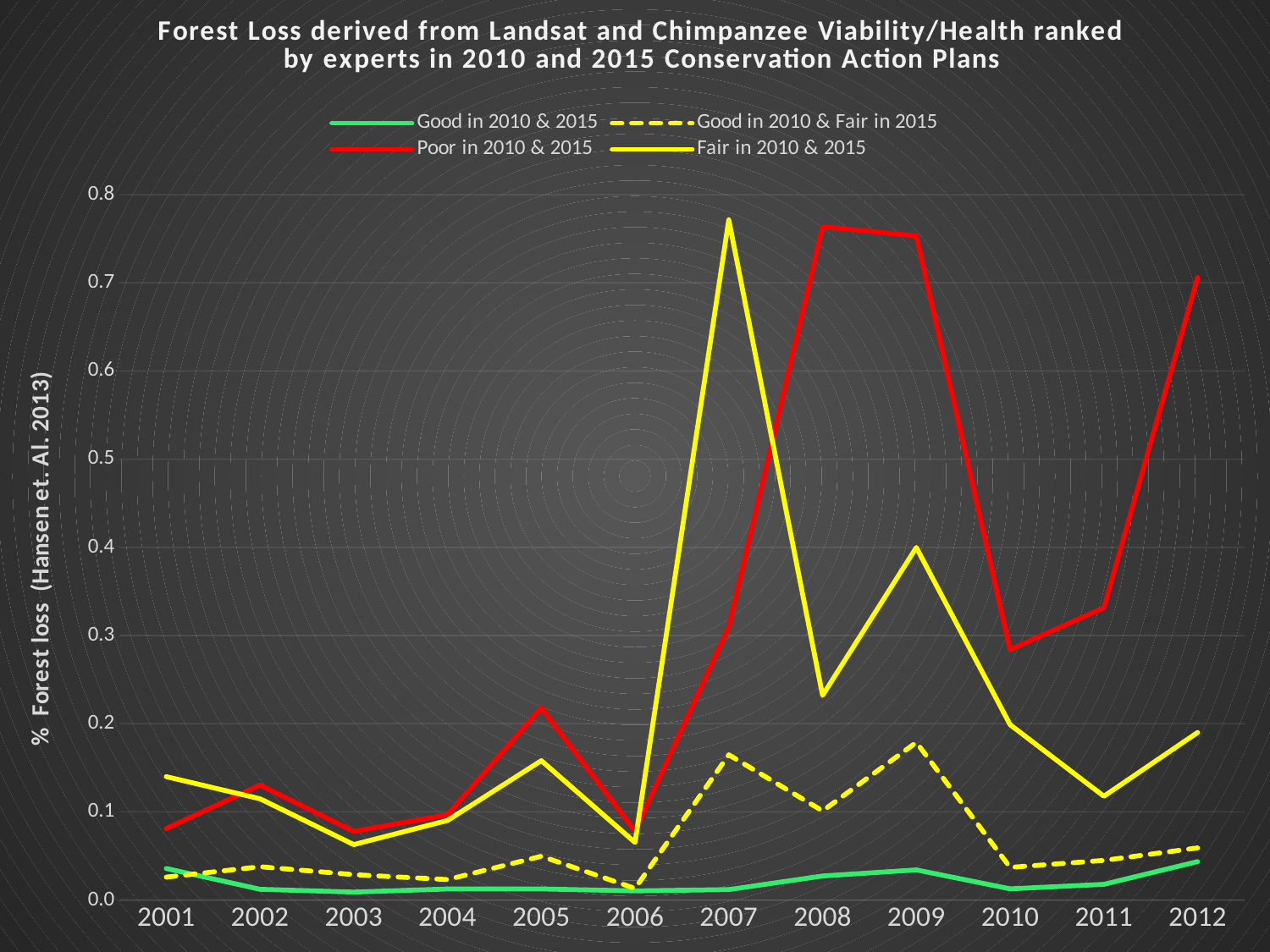
How many years are shown along the x axis? 12 In 2009, which is larger: Poor in 2010 & 2015 or Fair in 2010 & 2015? Poor in 2010 & 2015 How many series does the legend list? 4 Which series is drawn with a dashed line? Good in 2010 & Fair in 2015 Does the Poor in 2010 & 2015 series rise or fall from 2009 to 2010? fall Is the value for Poor in 2010 & 2015 in 2008 greater or less than 0.7? greater Which series has the lowest value in 2008? Good in 2010 & 2015 Is the value for Fair in 2010 & 2015 in 2007 greater or less than 0.7? greater Which series has the highest value in 2012? Poor in 2010 & 2015 What type of chart is shown on the slide? line chart Is the value for Fair in 2010 & 2015 in 2009 greater or less than 0.3? greater In which year does the Fair in 2010 & 2015 series reach its highest value? 2007